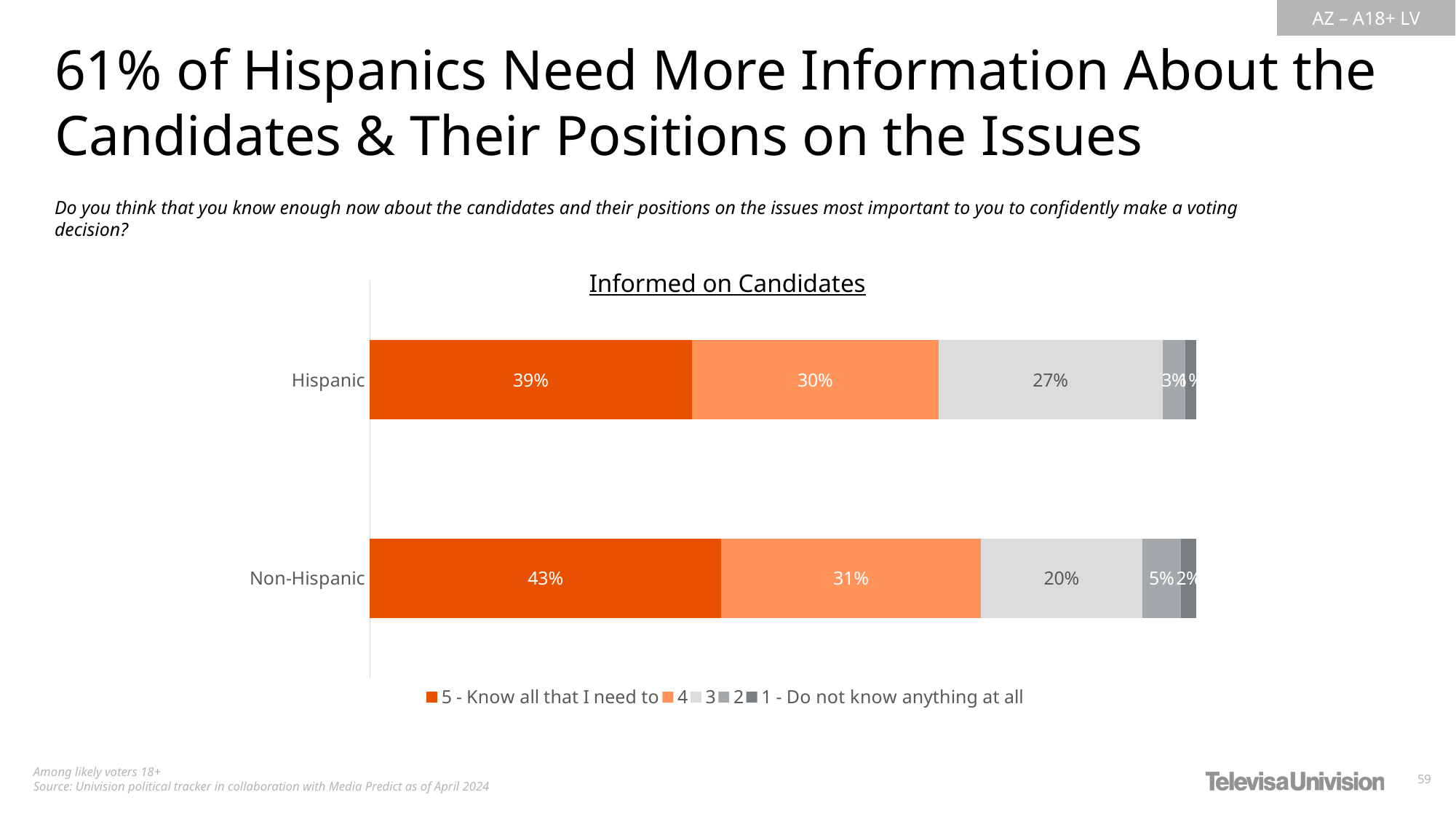
How many groups (categories) are shown in the chart? 2 What is the value for the "3" rating among Non-Hispanic respondents? 20% What is the value for the "2" rating among Non-Hispanic respondents? 5% How many percentage points higher is the "3" rating for Hispanic respondents than for Non-Hispanic respondents? 7 percentage points Which group has the larger share answering "5 - Know all that I need to", Hispanic or Non-Hispanic? Non-Hispanic What percentage of Non-Hispanic respondents answered "5 - Know all that I need to"? 43% What is the value for the "4" rating among Hispanic respondents? 30% What percentage of Hispanic respondents answered "5 - Know all that I need to"? 39% What is the difference between the Non-Hispanic and Hispanic values for "5 - Know all that I need to"? 4 percentage points How many series does the legend list? 5 What type of chart is shown on the slide? Stacked bar chart What is the value for the "3" rating among Hispanic respondents? 27%